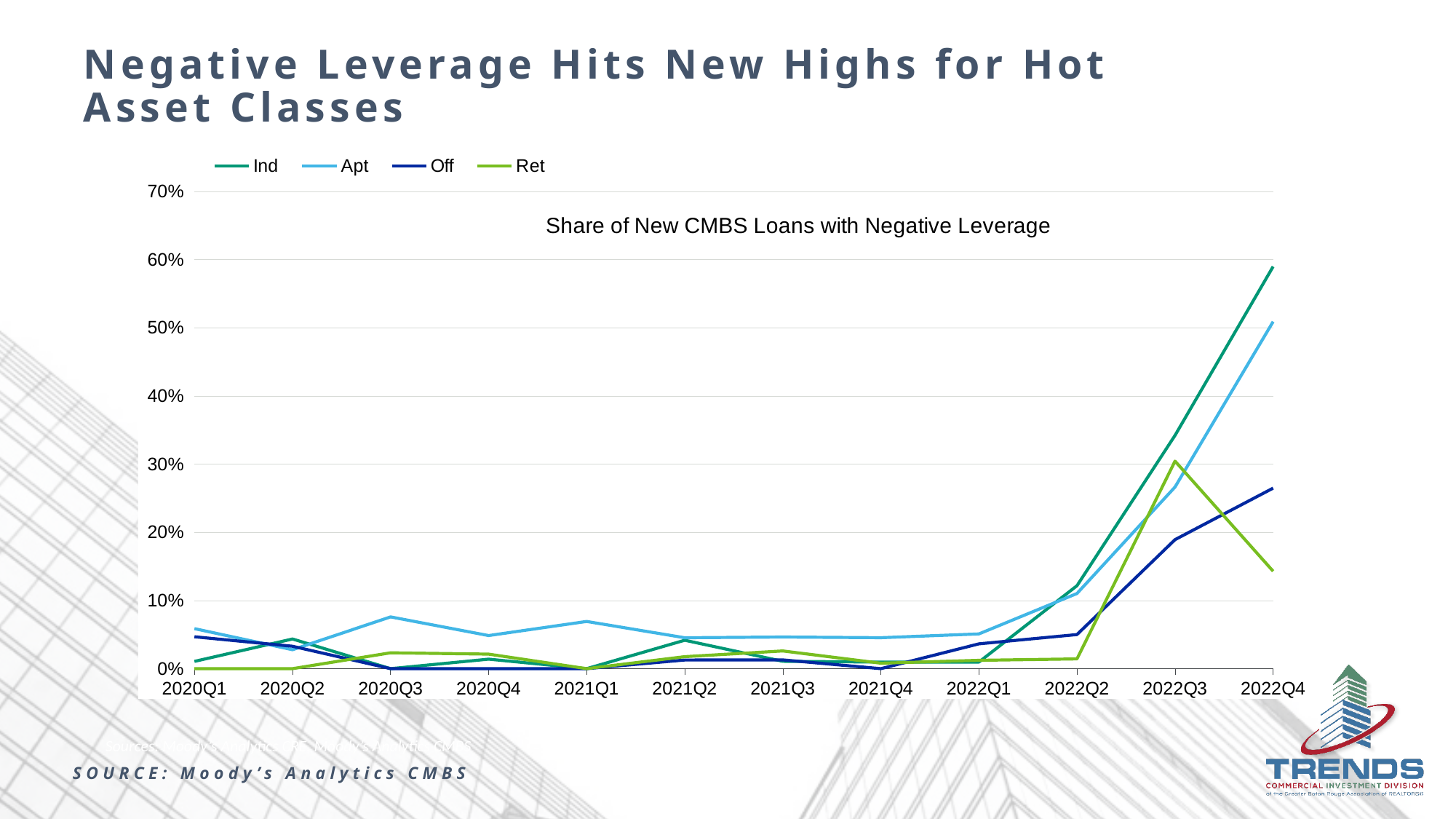
What is the title printed inside the chart area? Share of New CMBS Loans with Negative Leverage Is the value for Apt at 2022Q4 greater or less than 40%? greater How many series does the legend list? 4 What kind of chart is shown on the slide? line chart Does the Ind series rise or fall from 2022Q1 to 2022Q4? rise Is the value for Ret at 2022Q3 greater or less than 20%? greater How many quarters are shown along the x axis? 12 Is the value for Ind at 2022Q4 greater or less than 50%? greater Which series has the lowest value at 2022Q4? Ret Which series has the highest value at 2022Q4? Ind At 2022Q3, which is larger: the value for Ret or the value for Off? Ret